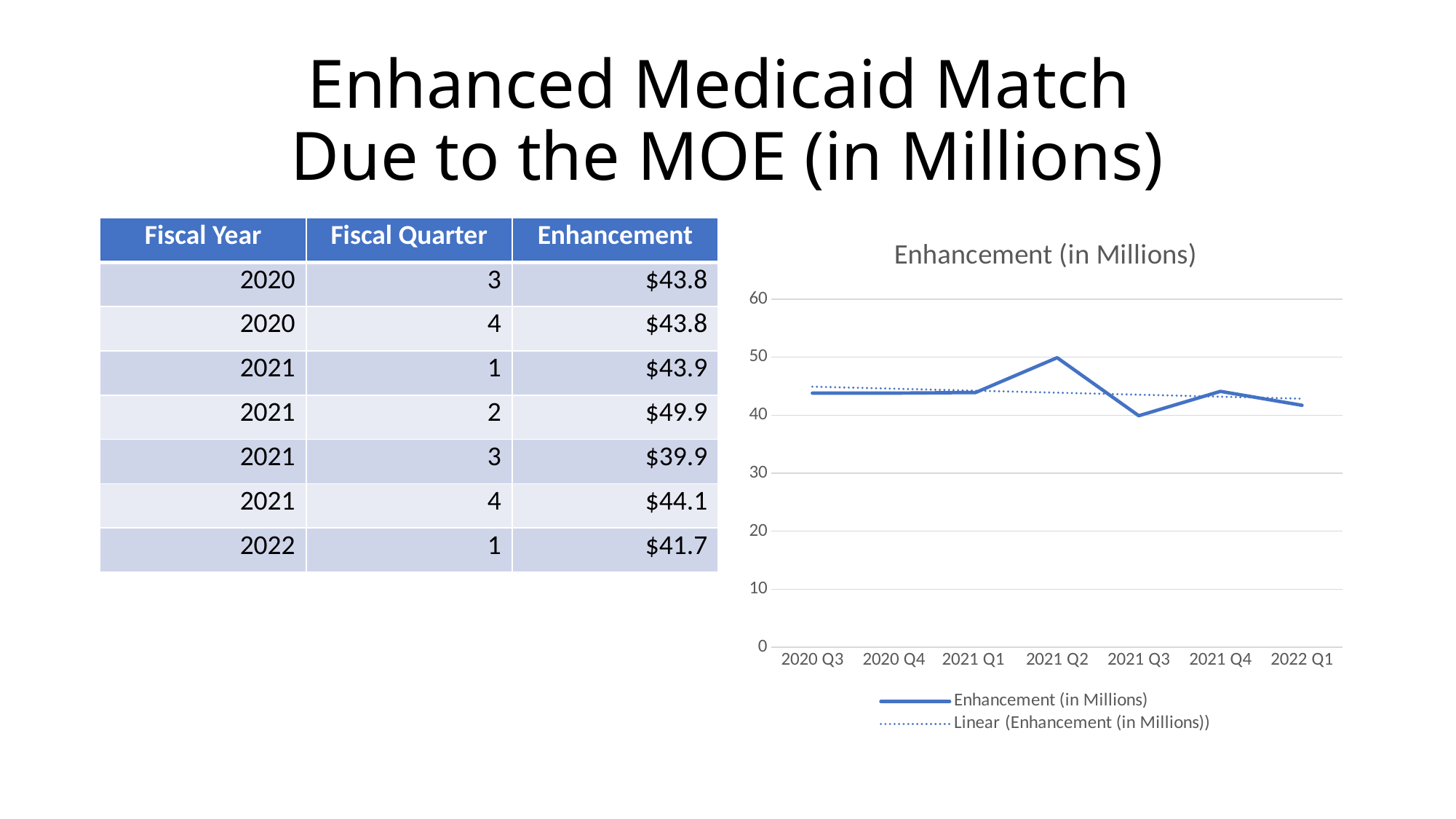
What is the title of the chart? Enhancement (in Millions) What is the difference between the Enhancement values for 2021 Q2 and 2021 Q3, using the values in the table? $10.0 What is the Enhancement value for 2021 Q2, as shown in the table on the slide? $49.9 How many series does the chart legend list? 2 Does the Enhancement line rise or fall from 2021 Q4 to 2022 Q1? fall What kind of chart is shown on the slide? line chart Is the Enhancement value for 2021 Q2 greater or less than 50? less Is the Enhancement value for 2021 Q2 larger or smaller than the value for 2021 Q3? larger How many quarters are plotted along the x axis of the chart? 7 Which quarter has the highest Enhancement value in the chart? 2021 Q2 Is the Enhancement value for 2021 Q3 greater or less than 40? less Which quarter has the lowest Enhancement value in the chart? 2021 Q3